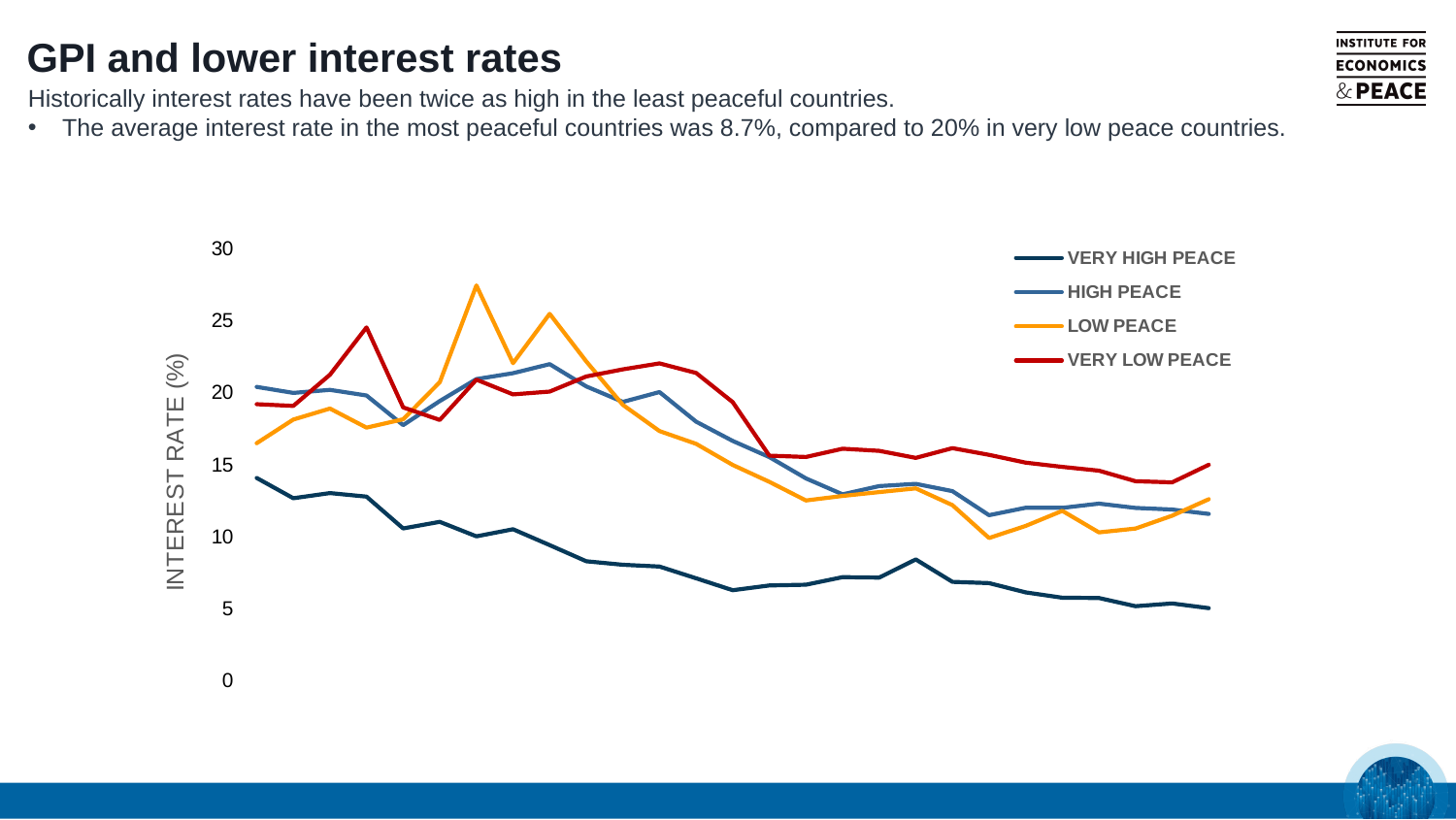
How many series does the legend list? 4 Which series reaches the highest peak value on the chart? LOW PEACE What are the four series named in the legend? VERY HIGH PEACE, HIGH PEACE, LOW PEACE, VERY LOW PEACE Is the highest point of the LOW PEACE line greater or less than 25? greater What is the label on the vertical axis? INTEREST RATE (%) What kind of chart is shown on the slide? Line chart Is the VERY HIGH PEACE line ever greater than 15? No Which series has the lowest values across the whole chart? VERY HIGH PEACE Is the value of the VERY LOW PEACE line at the right end of the chart greater or less than 10? greater At the right end of the chart, which is higher: the VERY LOW PEACE line or the VERY HIGH PEACE line? VERY LOW PEACE Does the VERY HIGH PEACE line generally rise or fall from left to right? Fall